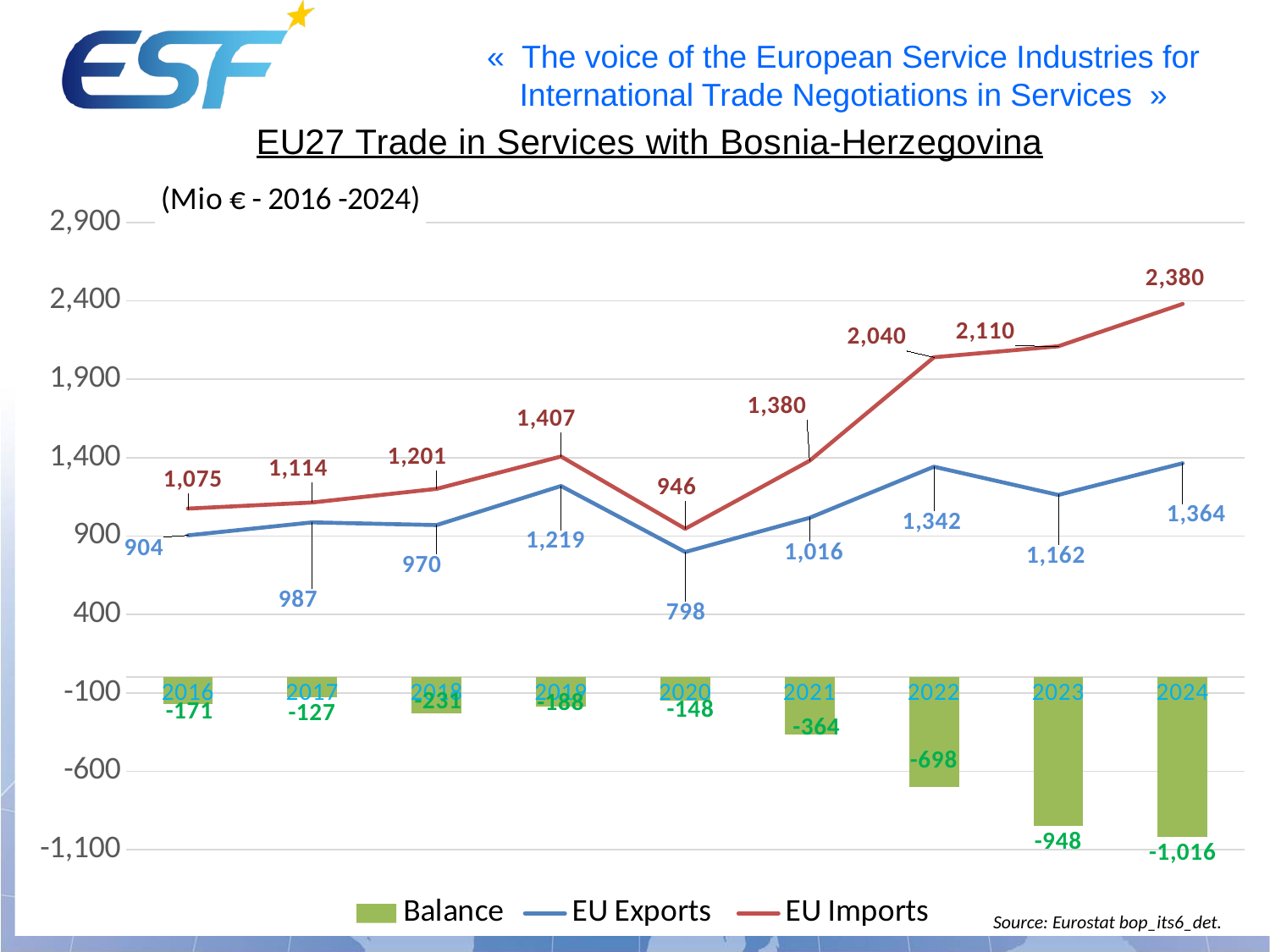
How many series does the legend list? 3 In which year were EU Imports lowest? 2020 What is the overall trend of EU Imports from 2020 to 2024? Rising What is the source cited for the chart data? Eurostat bop_its6_det. What was the value of EU Imports in 2024? 2,380 Is the value for EU Imports in 2023 greater or less than 1,900? greater In which year were EU Exports highest? 2024 How many years are shown on the x axis? 9 What is the difference between EU Imports and EU Exports in 2022? 698 Which was larger in 2019, EU Exports or EU Imports? EU Imports What was the Balance in 2021? -364 What was the value of EU Exports in 2020? 798